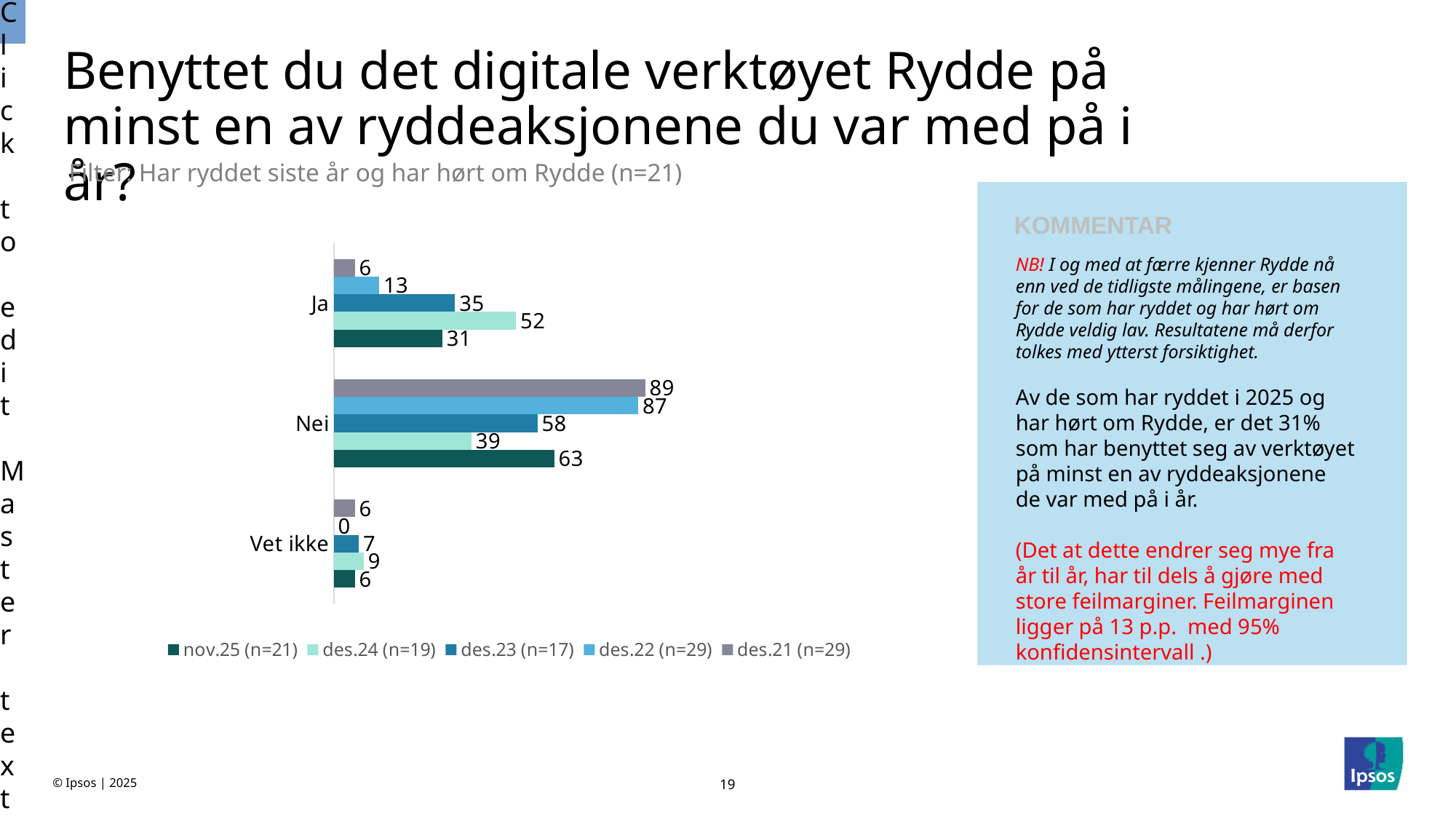
How many answer categories are shown on the chart? 3 How many series does the legend list? 5 What is the value for 'Ja' in the des.24 (n=19) series? 52 Which series has the highest value for 'Ja'? des.24 (n=19) Which series is shown in the darkest teal colour in the legend? nov.25 (n=21) Which series has the lowest value for 'Nei'? des.24 (n=19) What kind of chart is shown on the slide? bar chart What is the value for 'Nei' in the des.21 (n=29) series? 89 Which is larger: the 'Ja' value for des.23 (n=17) or for des.22 (n=29)? des.23 (n=17) What is the value for 'Vet ikke' in the des.22 (n=29) series? 0 What is the value for 'Ja' in the nov.25 (n=21) series? 31 What is the difference between the 'Nei' values for nov.25 (n=21) and des.24 (n=19)? 24